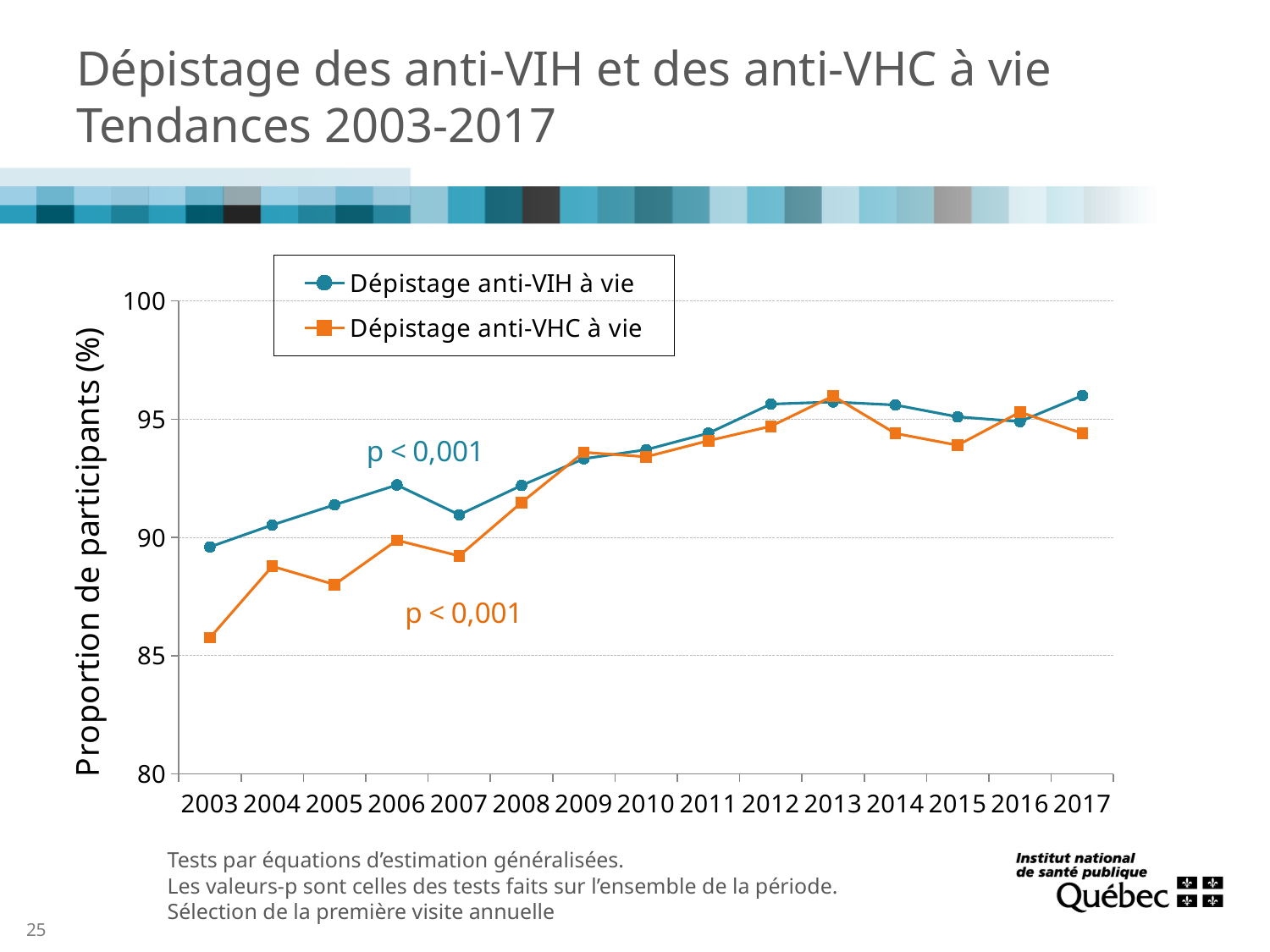
Overall, do the values for Dépistage anti-VHC à vie rise or fall from 2003 to 2017? rise What kind of chart is shown on the slide? line chart In 2007, which series has the higher value, Dépistage anti-VIH à vie or Dépistage anti-VHC à vie? Dépistage anti-VIH à vie In which year is the value for Dépistage anti-VHC à vie lowest? 2003 Is the value for Dépistage anti-VHC à vie in 2015 greater or less than 95? less In which year is the value for Dépistage anti-VIH à vie lowest? 2003 Is the value for Dépistage anti-VIH à vie in 2012 greater or less than 95? greater Is the value for Dépistage anti-VIH à vie in 2006 greater or less than 90? greater How many years are plotted along the x axis? 15 What is the label of the y axis? Proportion de participants (%) How many series does the legend list? 2